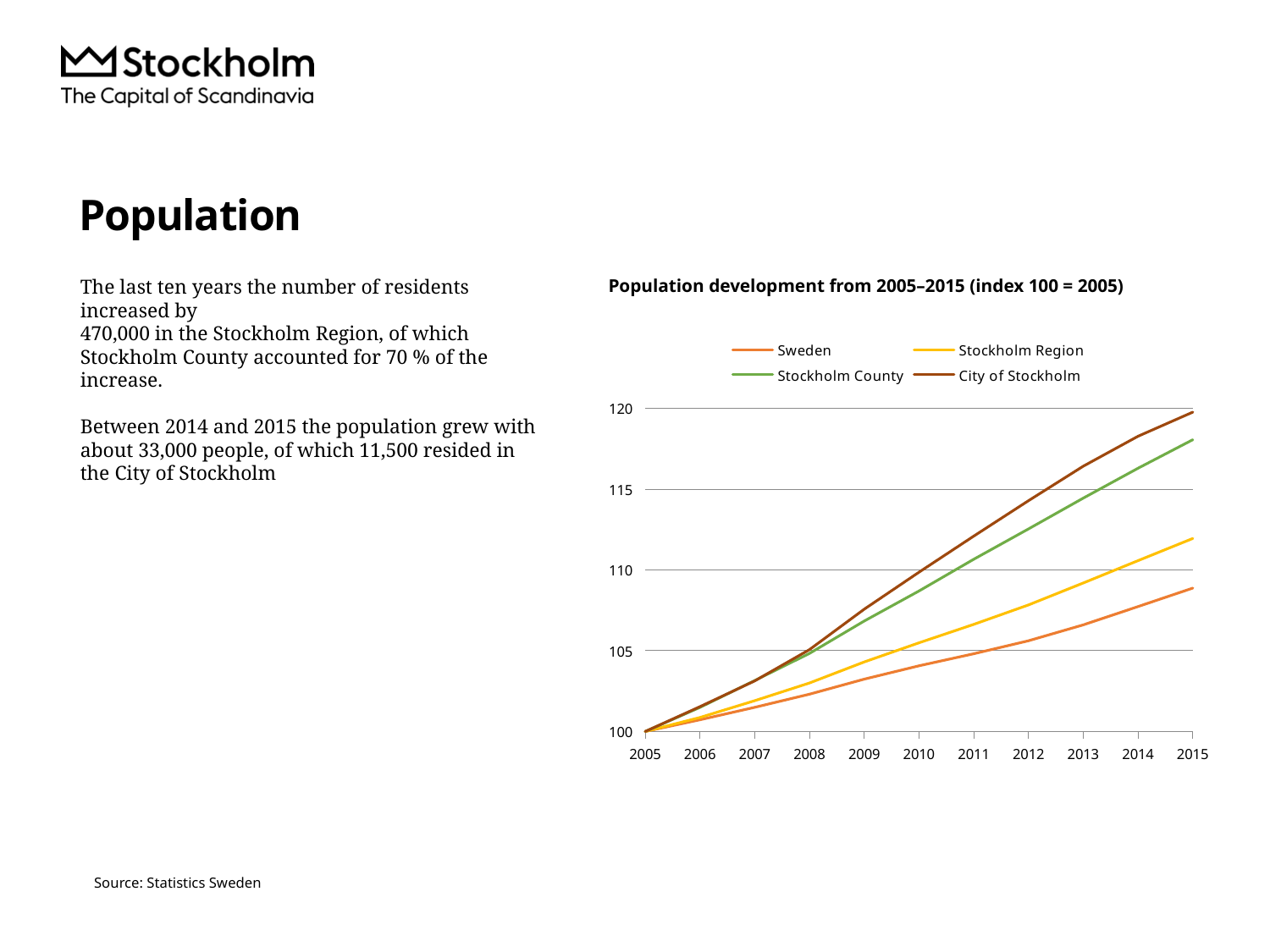
Which series has the lowest value in 2015? Sweden What kind of chart is shown on the slide? line chart Is the value for Sweden in 2015 greater or less than 110? less What is the index value for all series in 2005? 100 Is the value for Sweden in 2010 greater or less than 105? less Do the values for City of Stockholm rise or fall from 2005 to 2015? rise How many years are shown on the x axis of the chart? 11 How many series does the legend of the chart list? 4 In 2015, which is larger: Stockholm County or Stockholm Region? Stockholm County Is the value for City of Stockholm in 2015 greater or less than 115? greater What is the title of the chart? Population development from 2005–2015 (index 100 = 2005) Which series has the highest value in 2015? City of Stockholm